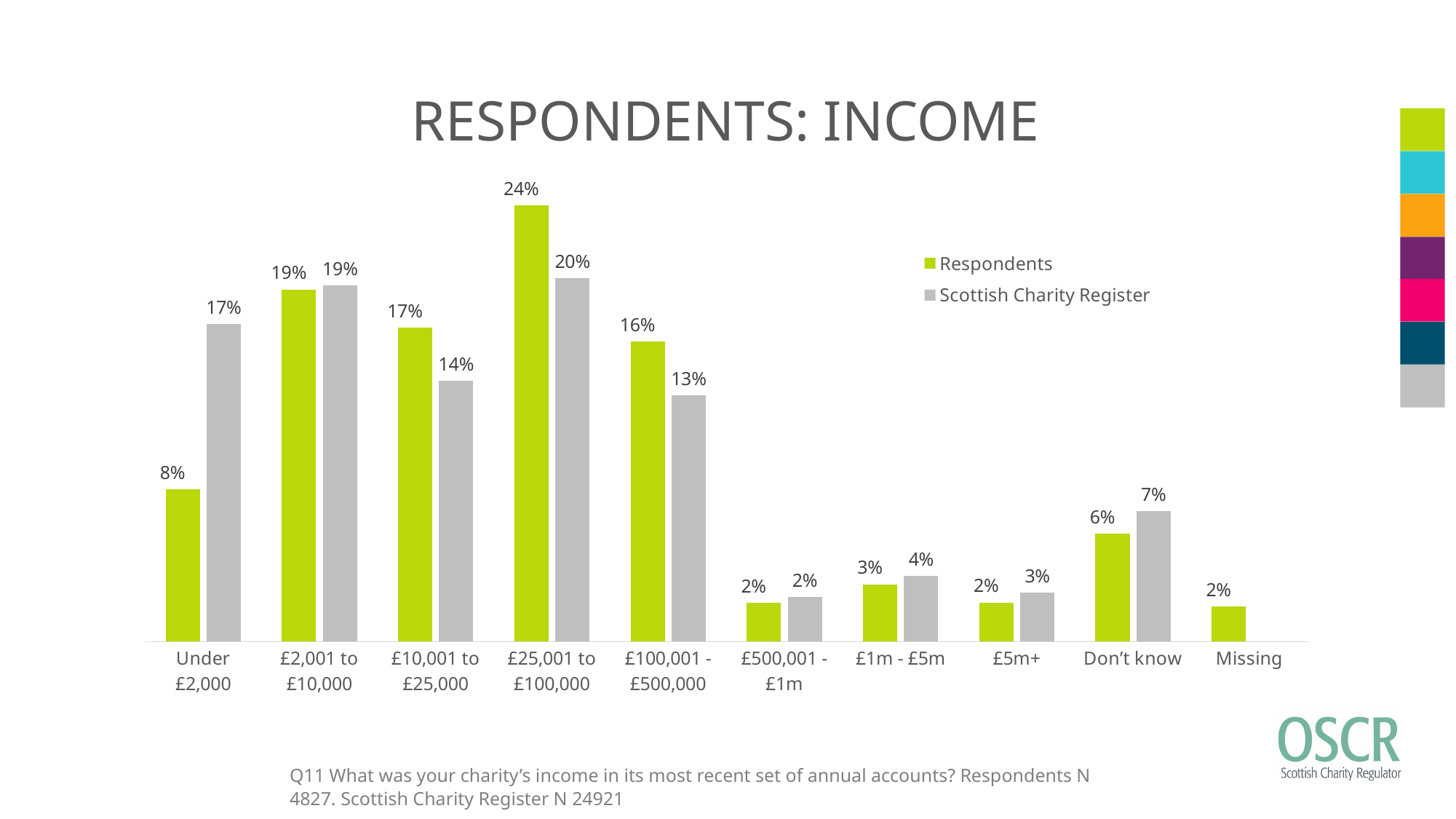
Which income category has the highest Respondents value? £25,001 to £100,000 What is the Respondents value for the Don't know category? 6% For the £100,001 - £500,000 category, which series has the larger value, Respondents or Scottish Charity Register? Respondents What is the title of the chart on the slide? RESPONDENTS: INCOME What is the difference between the Respondents and Scottish Charity Register values for Under £2,000? 9% What type of chart is shown on the slide? Bar chart What is the Scottish Charity Register value for the Under £2,000 category? 17% How many income categories are shown on the x axis? 10 Which income category has the lowest Scottish Charity Register value? £500,001 - £1m How many series does the legend list? 2 What percentage of Respondents have income of £25,001 to £100,000? 24% What is the difference between the Respondents and Scottish Charity Register values for £25,001 to £100,000? 4%